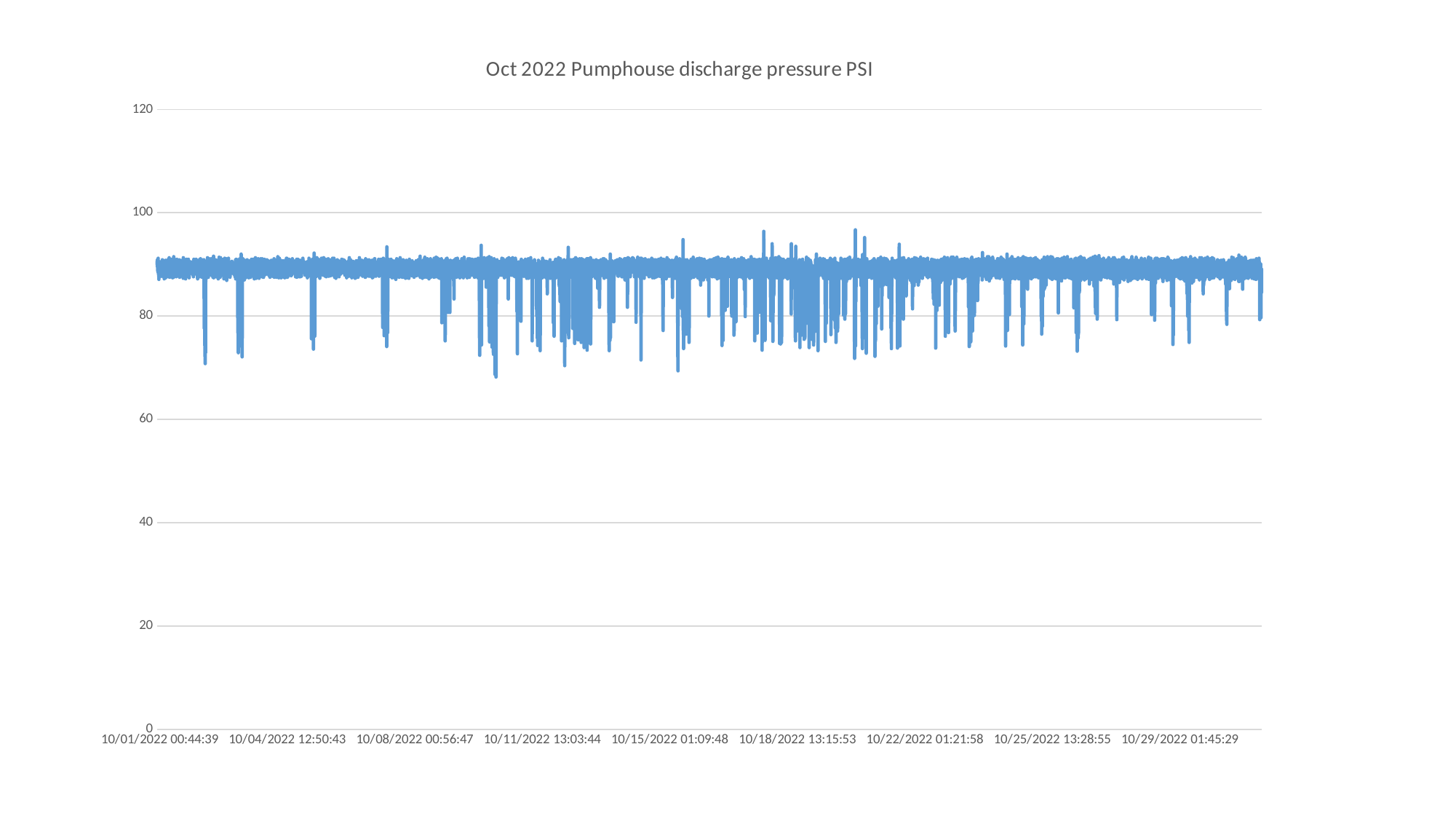
Is the lowest value plotted on the chart greater or less than 60? greater Do the dips in the line go below 80 or stay above 80? below 80 Is the baseline discharge pressure greater or less than 100? less Does the baseline discharge pressure generally rise, fall, or stay roughly flat across the month? roughly flat What kind of chart is shown on the slide? line chart What is the title of the chart? Oct 2022 Pumphouse discharge pressure PSI What is the last date label on the horizontal axis? 10/29/2022 01:45:29 What is the first date label on the horizontal axis? 10/01/2022 00:44:39 How many date labels are shown along the horizontal axis? 9 What is the highest value shown on the vertical axis? 120